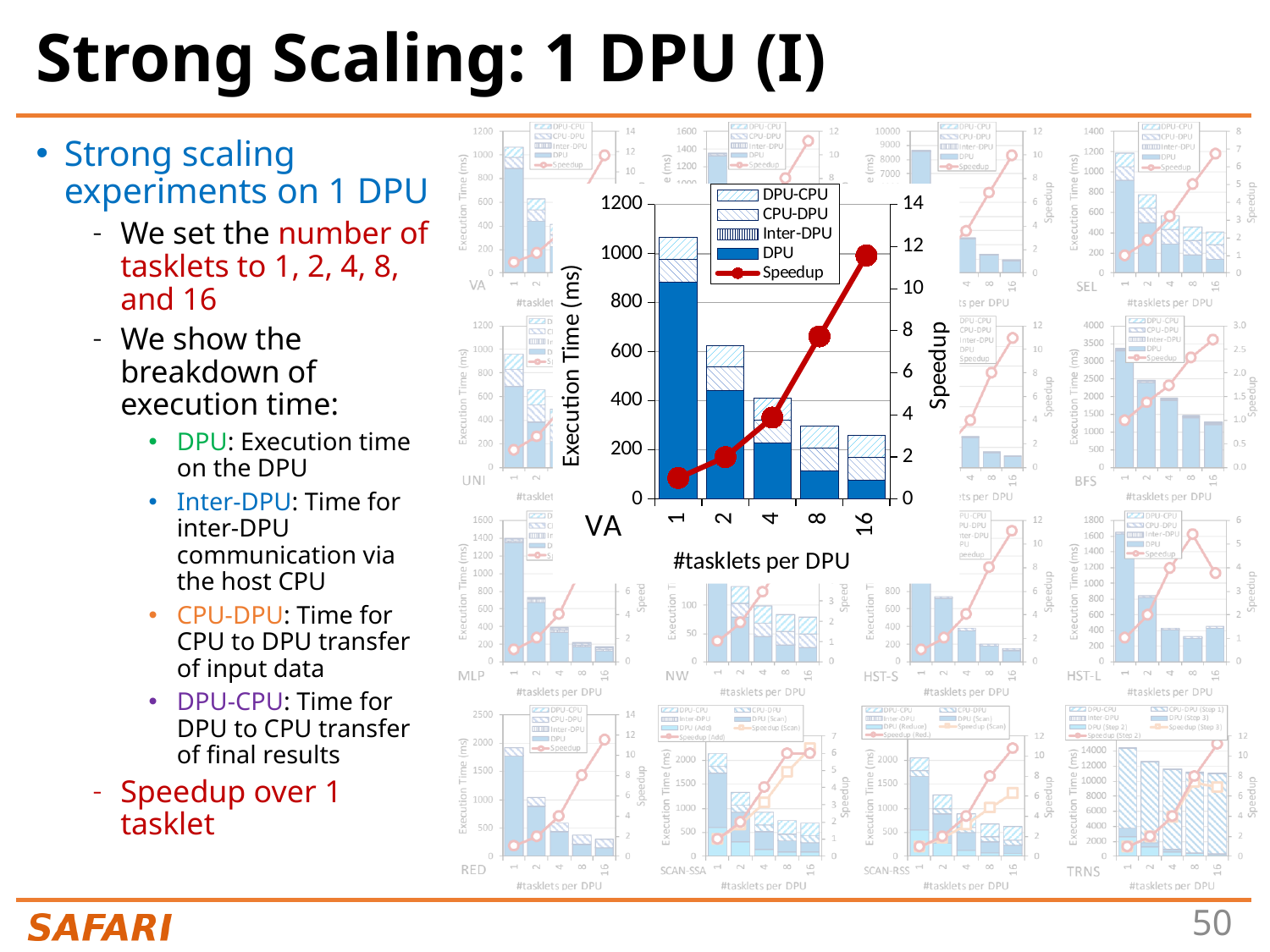
In the enlarged VA chart, does the total execution time rise or fall as the number of tasklets increases? falls In the enlarged VA chart, what is the label of the x axis? #tasklets per DPU In the enlarged VA chart, is the speedup for 16 tasklets greater or less than 10? greater In the enlarged VA chart, is the total execution time for 1 tasklet greater or less than 1000 ms? greater In the enlarged VA chart, does the speedup rise or fall as the number of tasklets increases? rises In the enlarged VA chart, which number of tasklets has the lowest total execution time? 16 In the enlarged VA chart, how many entries does the legend list? 5 In the enlarged VA chart, which series is drawn as a line with circular markers? Speedup In the enlarged VA chart, how many tasklet counts are shown on the x axis? 5 In the enlarged VA chart, which number of tasklets has the highest total execution time? 1 In the enlarged VA chart, what kind of chart is used to show the execution time breakdown? stacked bar chart In the enlarged VA chart, which has the larger total execution time, 2 tasklets or 4 tasklets? 2 tasklets